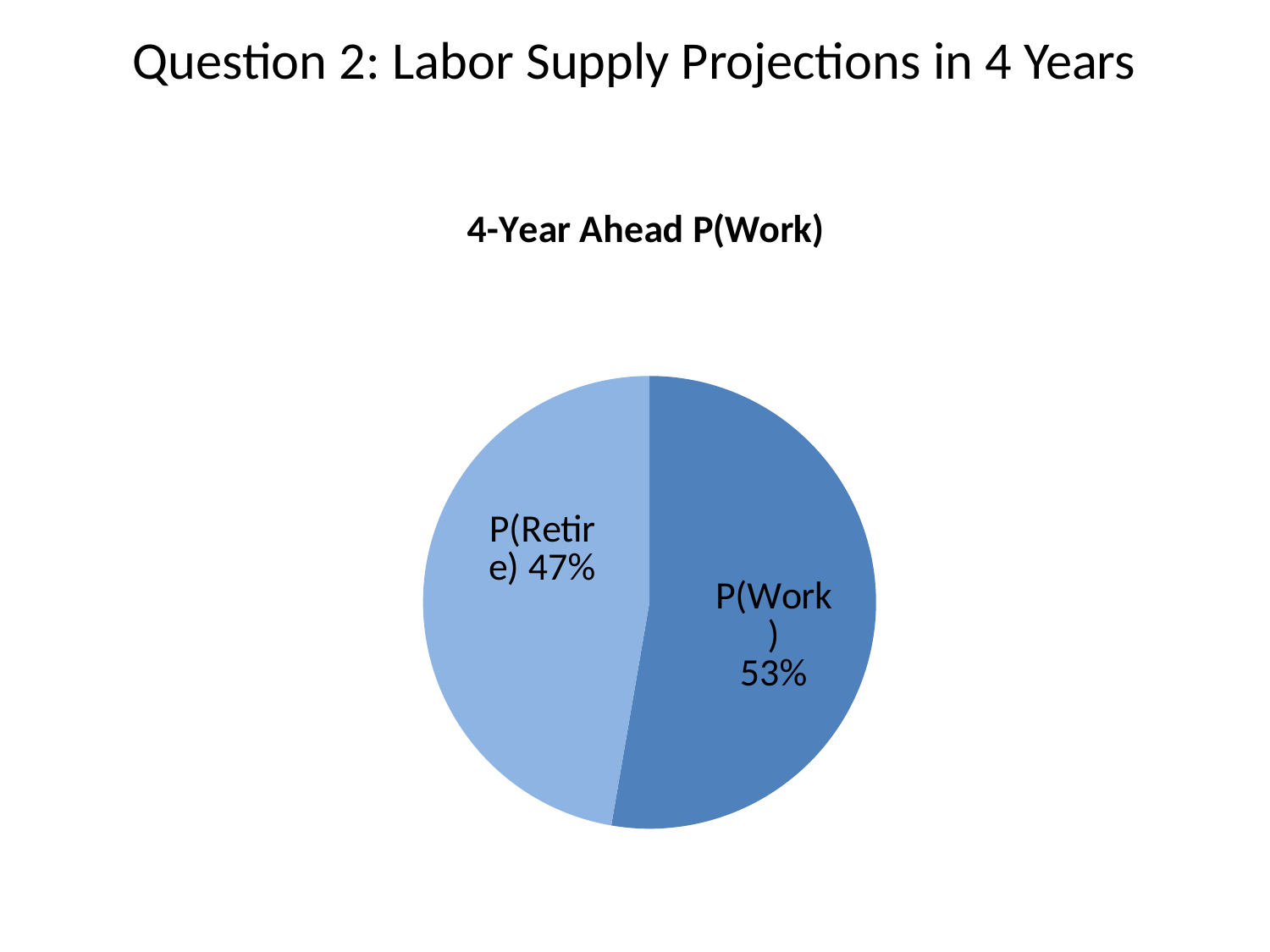
What kind of chart is shown on the slide? pie chart Which slice is the smallest? P(Retire) Which slice is shown in the lighter blue colour? P(Retire) Which slice is the largest? P(Work) How many slices does the pie chart have? 2 What share of the pie does P(Work) take? 53% What is the title of the chart? 4-Year Ahead P(Work) Which is larger, P(Work) or P(Retire)? P(Work) What is the difference in percentage points between P(Work) and P(Retire)? 6 What share of the pie does P(Retire) take? 47% Is the P(Work) slice greater or less than 50%? greater